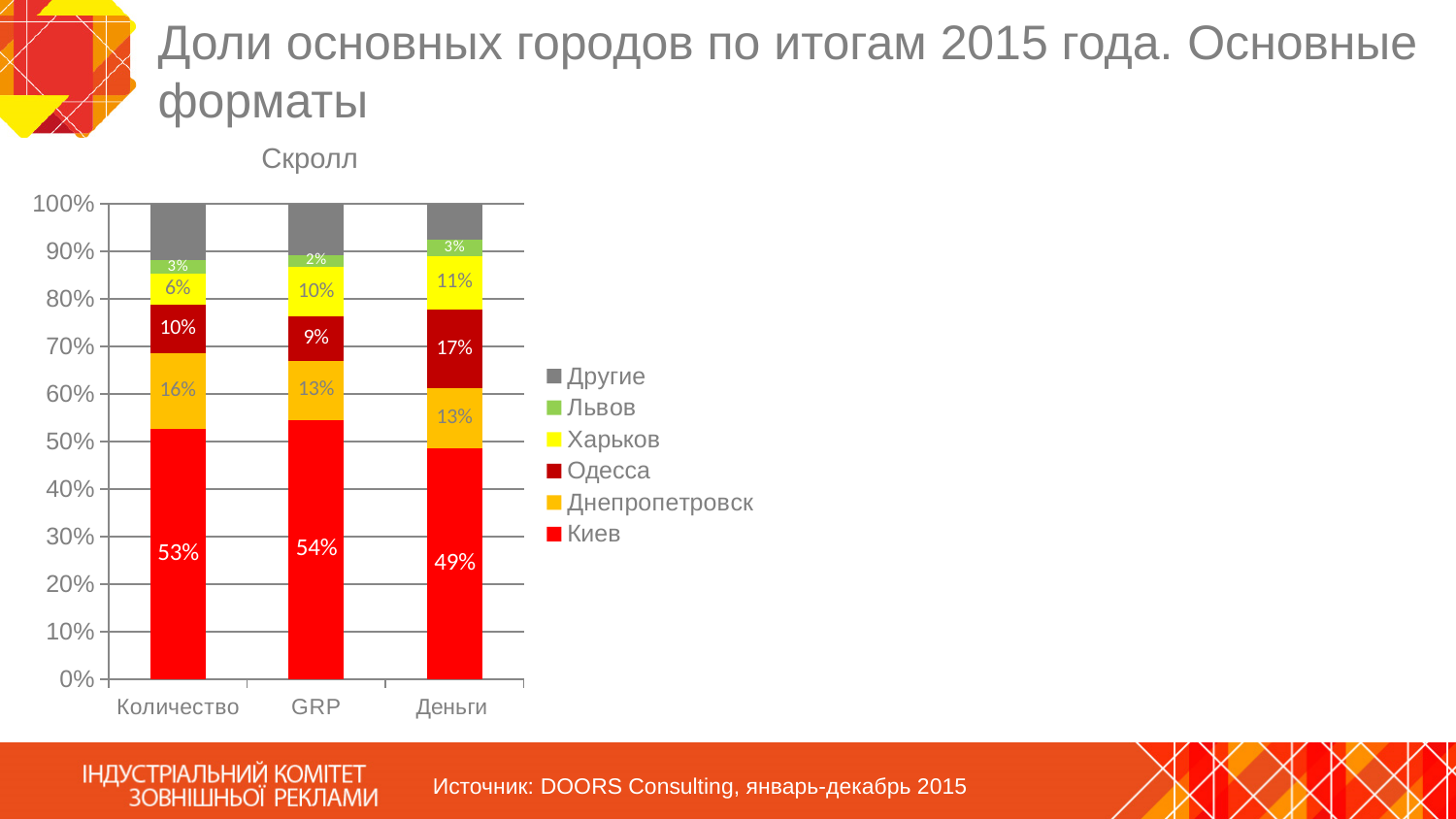
How many series does the legend list? 6 What is the value for Киев in the Количество bar? 53% Which is larger: the Днепропетровск share in Количество or in GRP? Количество What is the value for Днепропетровск in the Количество bar? 16% What is the value for Харьков in the GRP bar? 10% How many categories are shown on the x axis? 3 What kind of chart is shown? Stacked bar chart What is the value for Одесса in the Деньги bar? 17% In which category is the Киев share highest? GRP In which category is the Одесса share lowest? GRP What is the value for Львов in the GRP bar? 2% What is the difference between the Одесса share in Деньги and in Количество? 7%